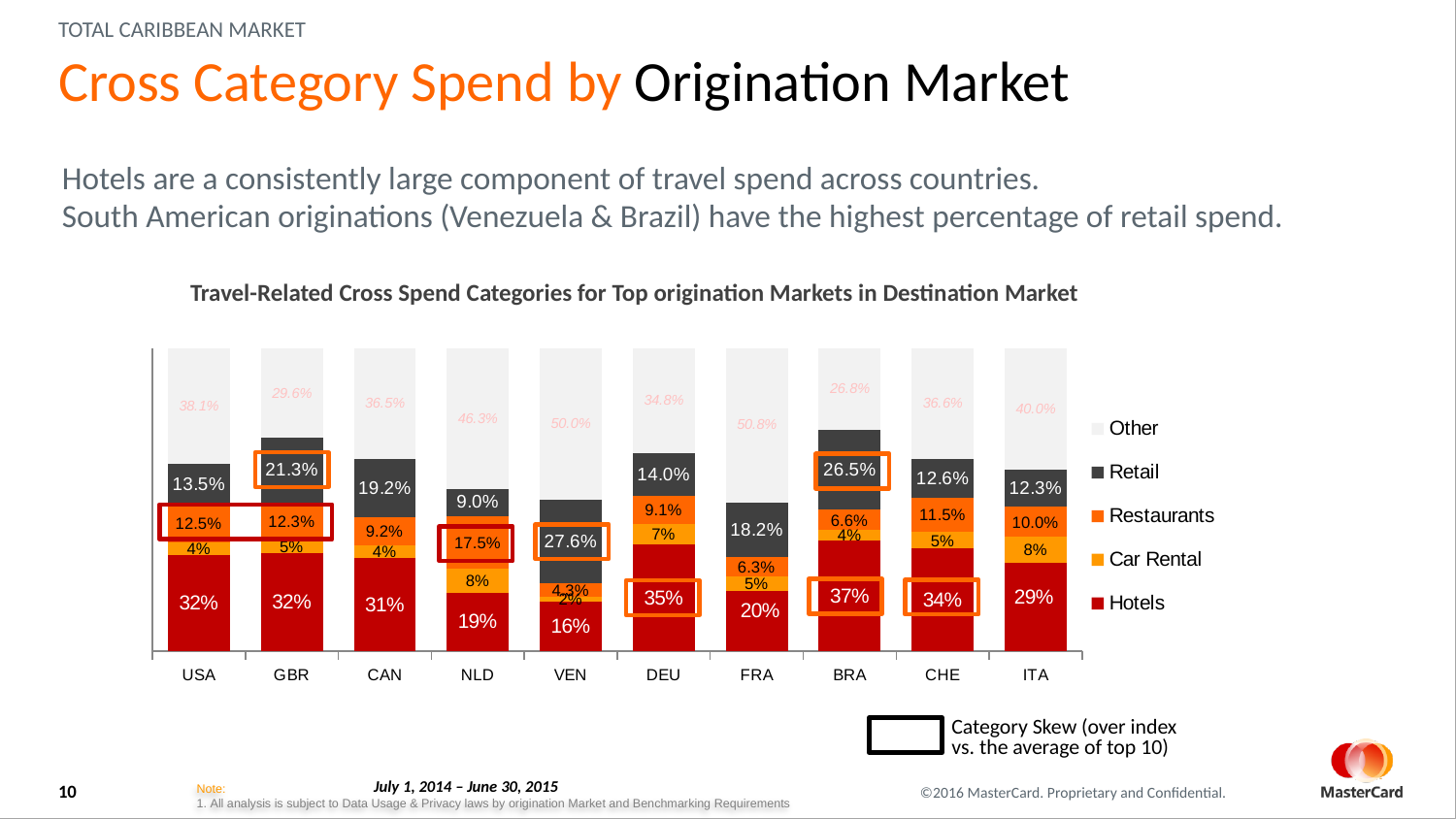
What is the Restaurants share for NLD? 17.5% Which origination market has the highest Retail share? VEN What is the Retail share for GBR? 21.3% What is the difference between the Hotels share for DEU and the Hotels share for FRA? 15% Which legend entry is shown in red? Hotels Which origination market has the lowest Hotels share? VEN How many origination markets are shown on the x axis of the chart? 10 What type of chart is shown on the slide? stacked bar chart Which is larger, the Restaurants share for USA or the Restaurants share for CAN? USA How many series does the chart legend list? 5 Which origination market has the highest Hotels share? BRA What is the Hotels share for BRA? 37%